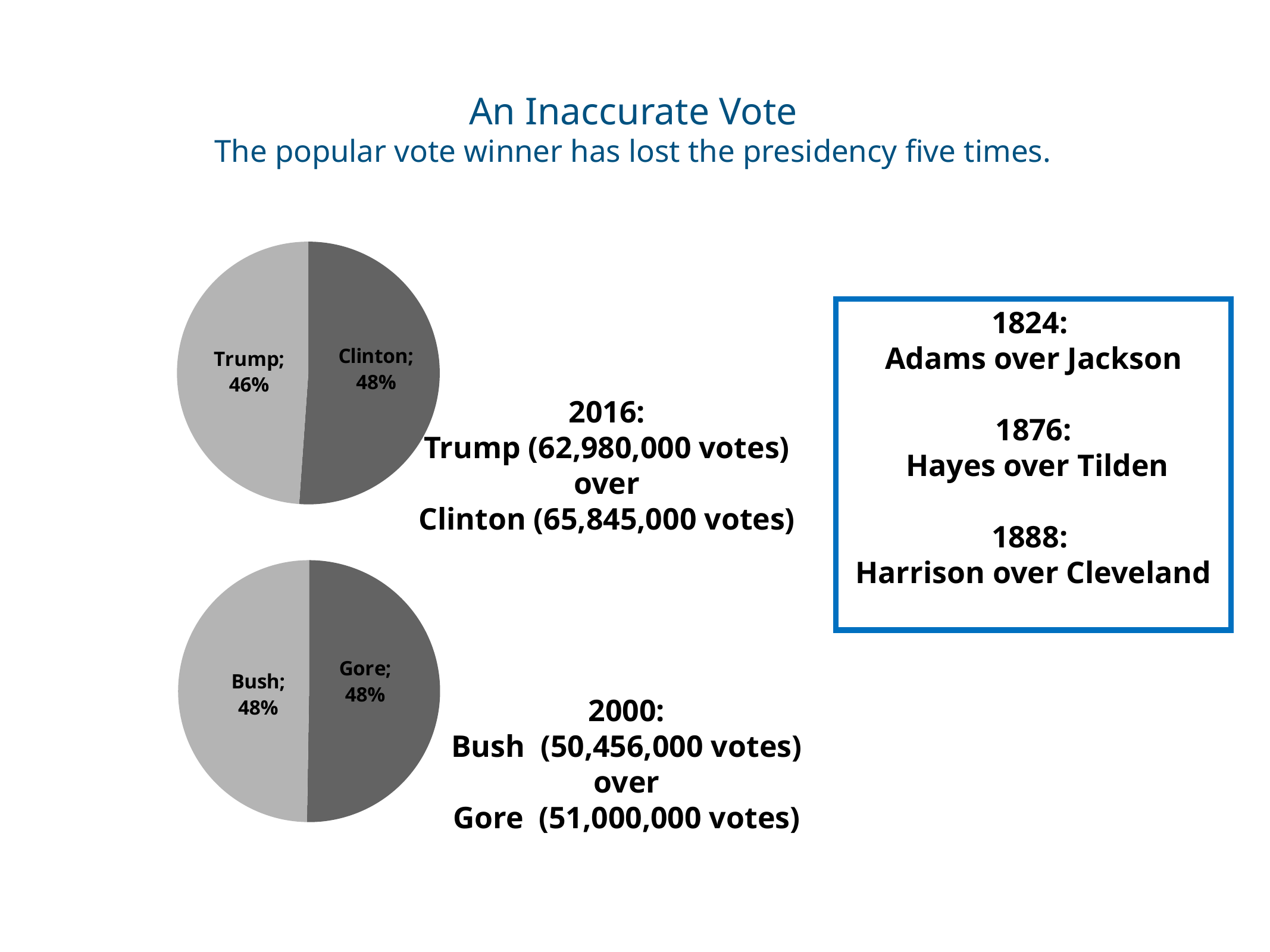
How many slices does the top pie chart have? 2 In the bottom pie chart, what percentage is shown for Gore? 48% In the top pie chart, what percentage is shown for Clinton? 48% What kind of chart is the top chart on the slide? pie chart In the top pie chart, which candidate has the largest share? Clinton In the top pie chart, what percentage is shown for Trump? 46% How many slices does the bottom pie chart have? 2 In the bottom pie chart, what percentage is shown for Bush? 48% In the top pie chart, what is the difference in percentage points between Clinton's and Trump's shares? 2 percentage points How many pie charts are shown on the slide? 2 In the top pie chart, which slice is larger, Trump or Clinton? Clinton In the top pie chart, which candidate's slice is the darker grey? Clinton